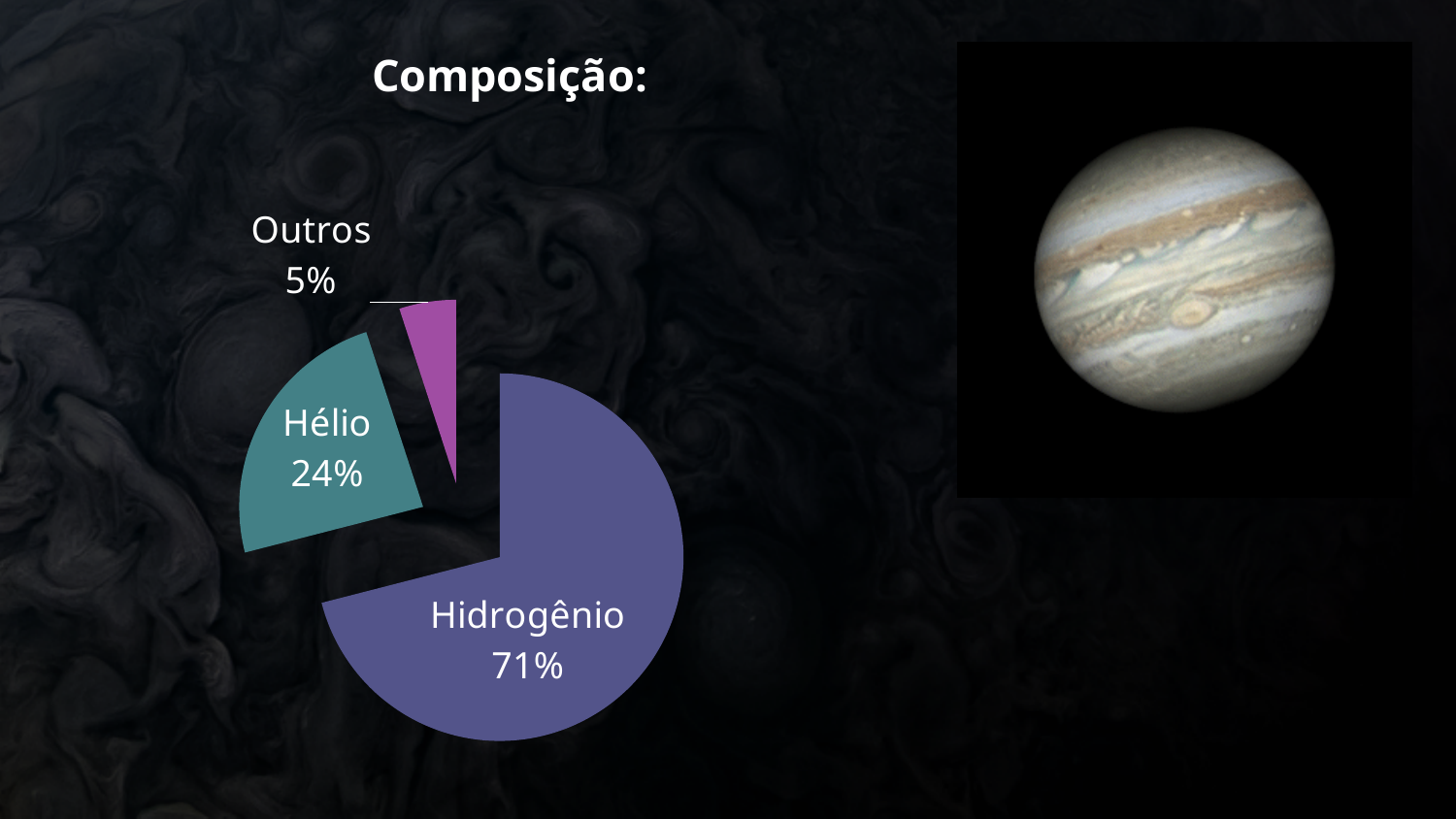
What percentage does the Hélio slice show? 24% How many slices does the pie chart have? 3 What percentage does the Outros slice show? 5% What is the difference in percentage points between Hélio and Outros? 19 What is the difference in percentage points between Hidrogênio and Hélio? 47 What colour is the Hidrogênio slice? purple Which slice of the pie is the smallest? Outros What percentage does the Hidrogênio slice show? 71% Which is larger, the Hélio slice or the Outros slice? Hélio Which slice of the pie is the largest? Hidrogênio What kind of chart is shown on the slide? pie chart What is the title shown above the pie chart? Composição: